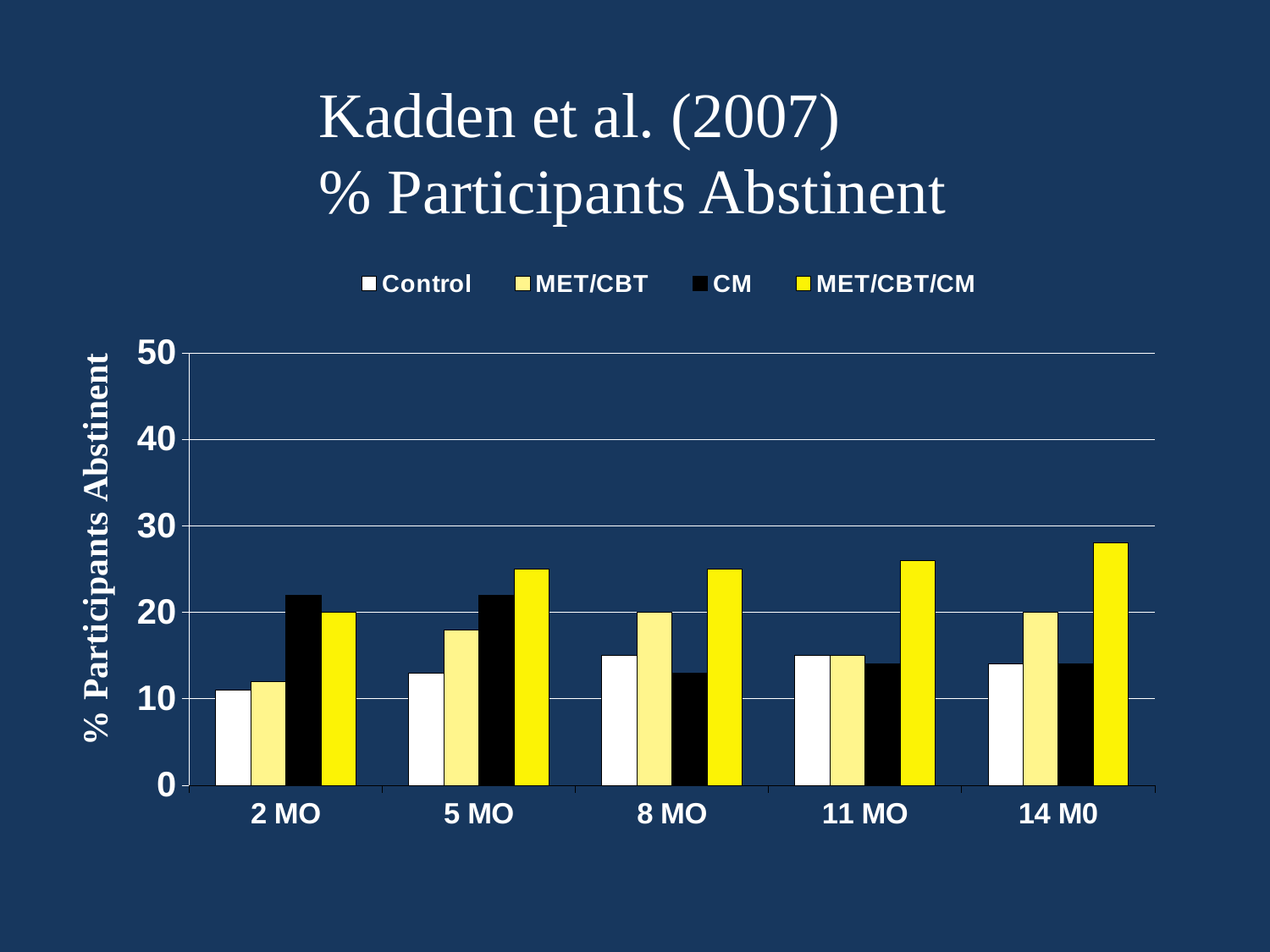
Is the value for CM at 5 MO greater or less than 20? greater Does the MET/CBT/CM series generally rise or fall from 2 MO to 14 M0? rise What colour represents the CM series in the legend? black How many time-point categories are shown on the x axis? 5 What kind of chart is shown on the slide? bar chart How many series does the legend list? 4 What is the title of the y axis? % Participants Abstinent Is the value for Control at 2 MO greater or less than 20? less Which series has the lowest value at 5 MO? Control Is the value for MET/CBT/CM at 14 M0 greater or less than 20? greater At 8 MO, which is larger: MET/CBT or CM? MET/CBT Which series has the highest value at 14 M0? MET/CBT/CM